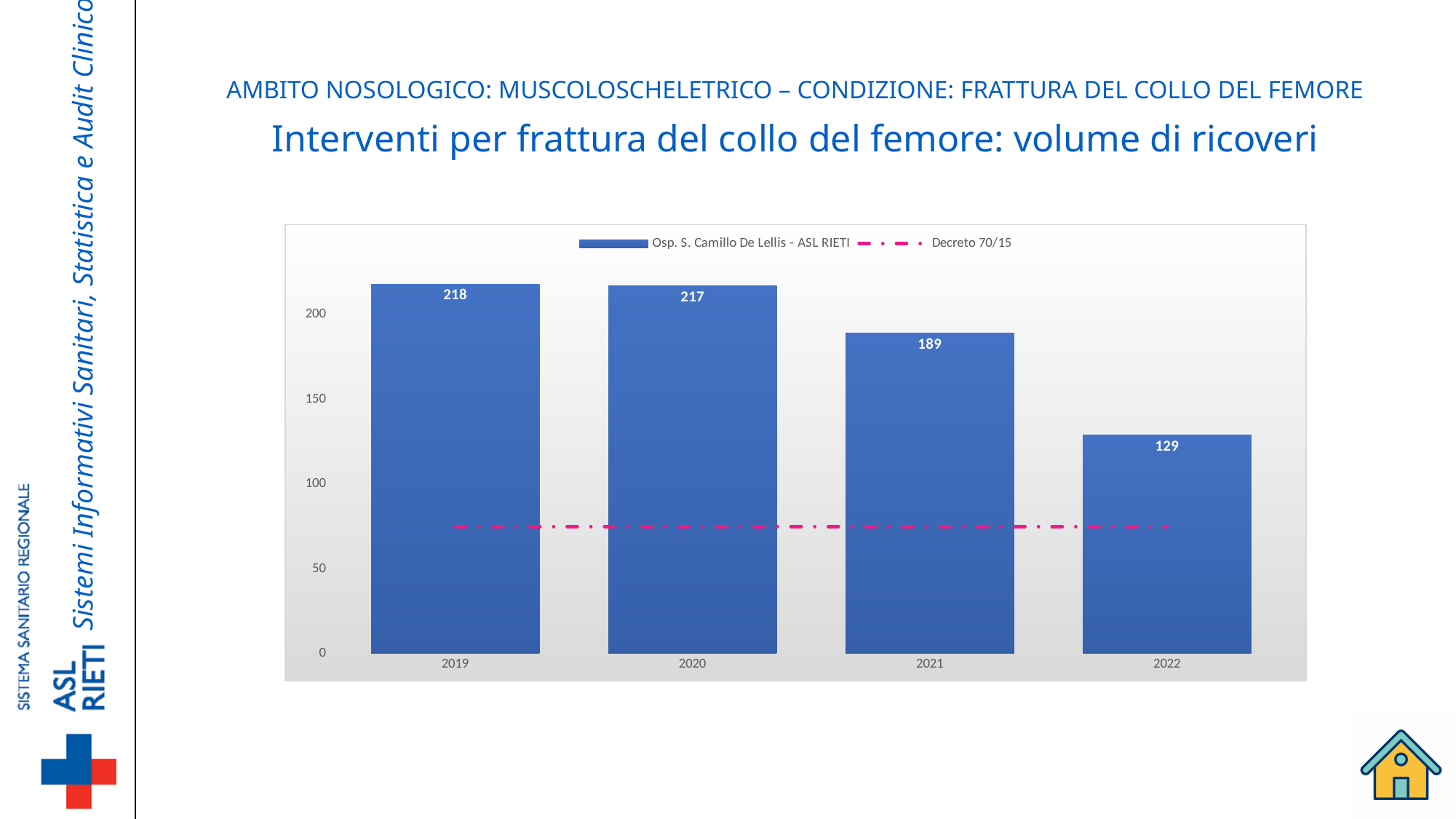
What is the value for 2021? 189 Which year has the lowest value? 2022 Which is larger, the value for 2020 or the value for 2021? 2020 What is the value for 2022? 129 What is the value for 2019? 218 Which year has the highest value? 2019 How many years are shown on the x axis? 4 How many series does the legend list? 2 What kind of chart is this? bar chart Do the bar values rise or fall from 2019 to 2022? fall What is the difference between the values for 2019 and 2022? 89 Is the Decreto 70/15 line greater or less than 100? less